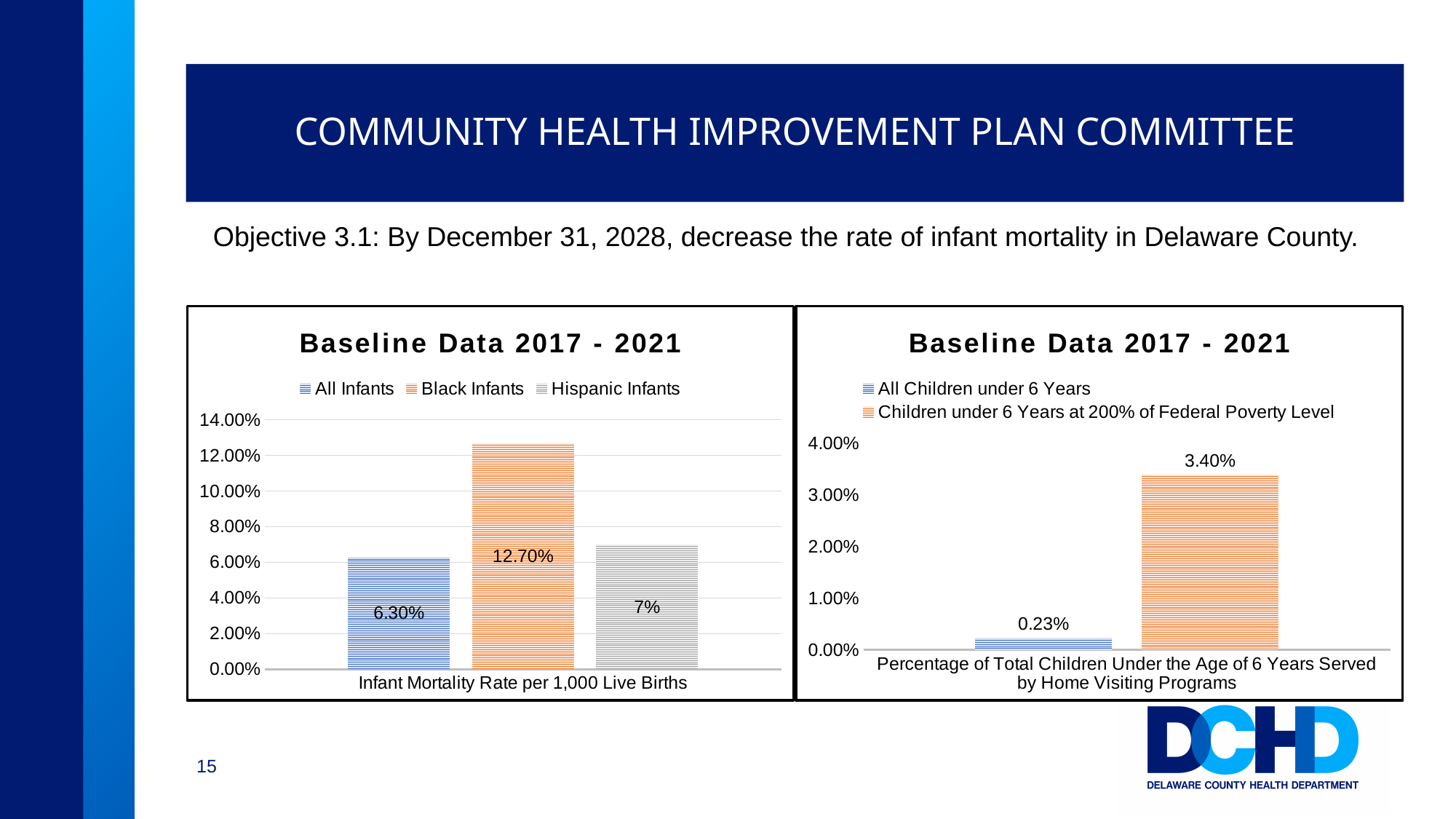
In the left chart, what is the value for All Infants? 6.30% In the right chart, what is the value for All Children under 6 Years? 0.23% In the right chart, what is the value for Children under 6 Years at 200% of Federal Poverty Level? 3.40% In the right chart, which series has the larger value: All Children under 6 Years or Children under 6 Years at 200% of Federal Poverty Level? Children under 6 Years at 200% of Federal Poverty Level In the left chart, which series has the highest infant mortality rate? Black Infants In the left chart, what is the value for Black Infants? 12.70% In the left chart, what is the difference between the Black Infants value and the All Infants value? 6.40% In the left chart, which series has the lowest infant mortality rate? All Infants What kind of chart is the right chart? Bar chart In the left chart, how many series does the legend list? 3 In the right chart, what is the difference between the two plotted values? 3.17% In the left chart, what is the value for Hispanic Infants? 7%